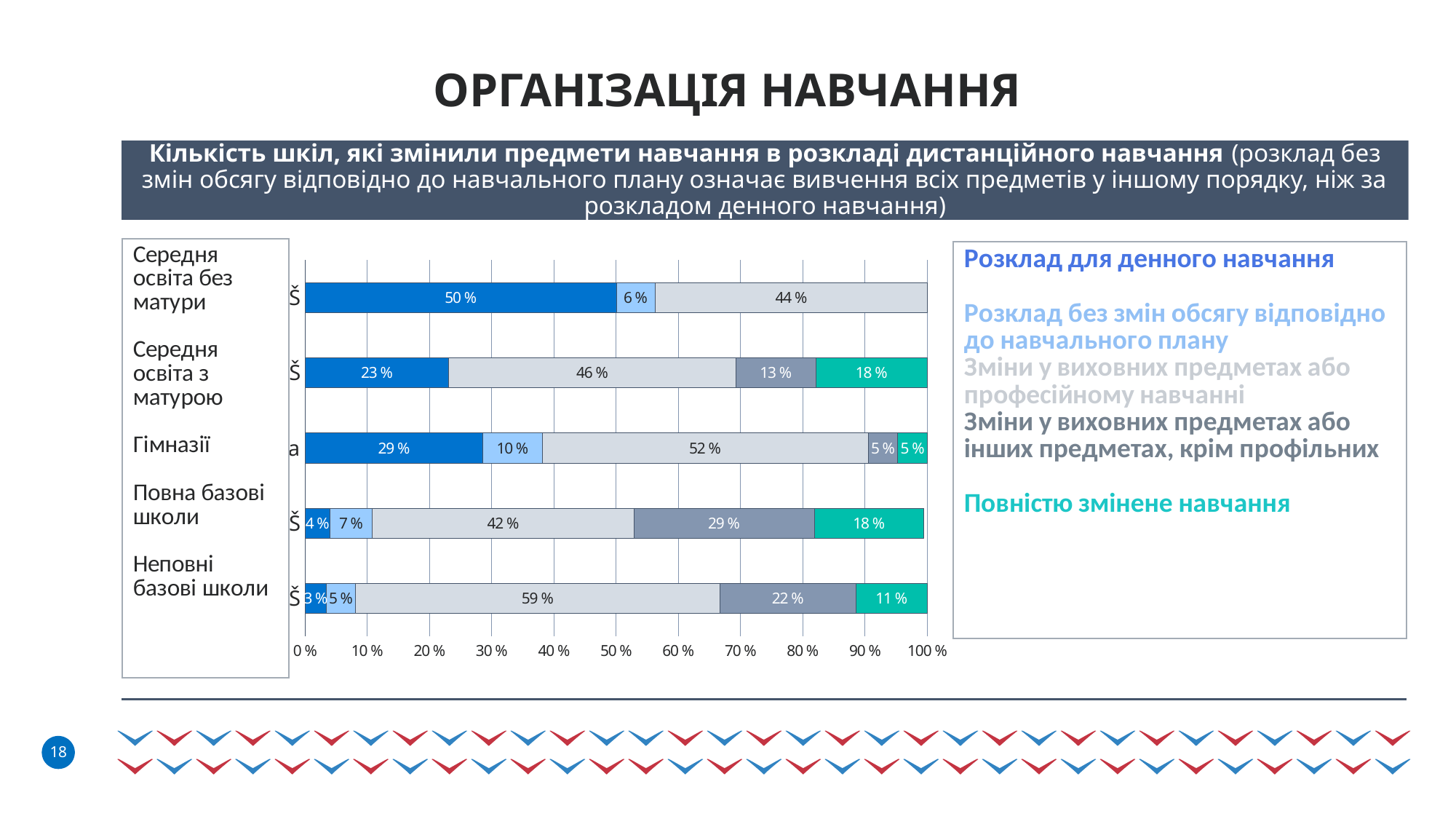
What is the difference between the 'Зміни у виховних предметах або професійному навчанні' values for 'Неповні базові школи' and 'Повна базові школи'? 17 % What is the value of 'Повністю змінене навчання' for 'Середня освіта з матурою'? 18 % Which is larger: the 'Повністю змінене навчання' value for 'Неповні базові школи' or for 'Повна базові школи'? Повна базові школи How many school categories are plotted in the chart? 5 Which category has the lowest value for 'Розклад для денного навчання'? Неповні базові школи What kind of chart is shown on the slide? Stacked bar chart What is the value of 'Зміни у виховних предметах або інших предметах, крім профільних' for 'Повна базові школи'? 29 % What is the value of 'Зміни у виховних предметах або професійному навчанні' for 'Гімназії'? 52 % What is the value of 'Розклад для денного навчання' for 'Середня освіта без матури'? 50 % Which category has the highest value for 'Розклад для денного навчання'? Середня освіта без матури How many series does the legend list? 5 What colour represents 'Повністю змінене навчання' in the chart? Teal